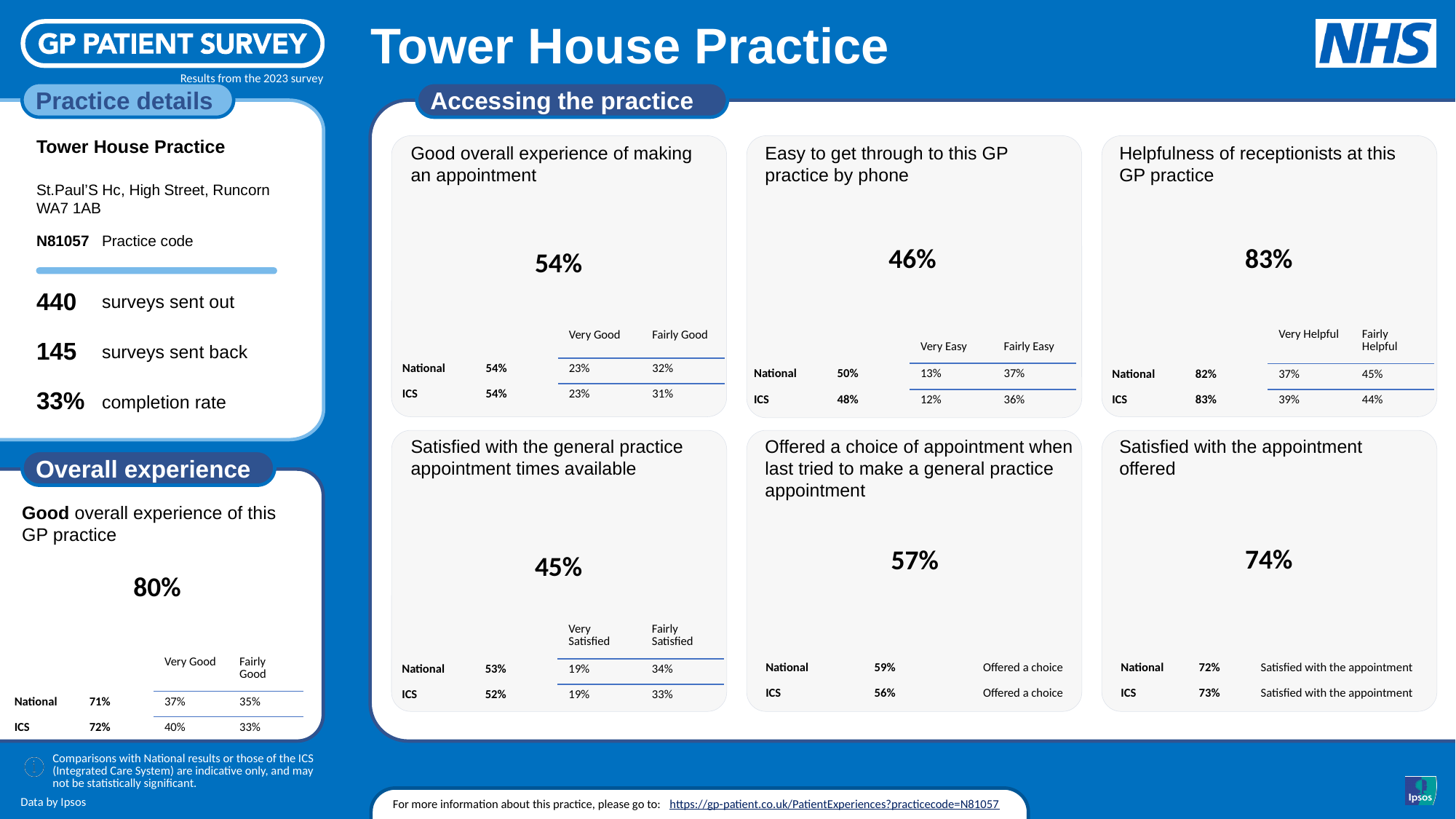
On the 'Satisfied with the general practice appointment times available' panel, what is the National 'Fairly Satisfied' percentage? 34% On the 'Offered a choice of appointment' panel, what is the ICS value? 56% On the 'Satisfied with the appointment offered' panel, what is the difference between the practice's headline value and the National value? 2% On the 'Overall experience' panel, what is the practice's headline percentage for good overall experience of this GP practice? 80% Among the six 'Accessing the practice' panels, which has the highest headline percentage? Helpfulness of receptionists at this GP practice On the 'Easy to get through to this GP practice by phone' panel, what is the National value? 50% Among the six 'Accessing the practice' panels, which has the lowest headline percentage? Satisfied with the general practice appointment times available On the 'Easy to get through to this GP practice by phone' panel, is the practice's headline value higher or lower than the ICS value? lower On the 'Helpfulness of receptionists at this GP practice' panel, what is the ICS 'Very Helpful' percentage? 39% How many panels are shown in the 'Accessing the practice' section? 6 On the 'Overall experience' panel, what is the difference between the ICS 'Very Good' and 'Fairly Good' percentages? 7% On the 'Good overall experience of making an appointment' panel, what is the practice's headline percentage? 54%